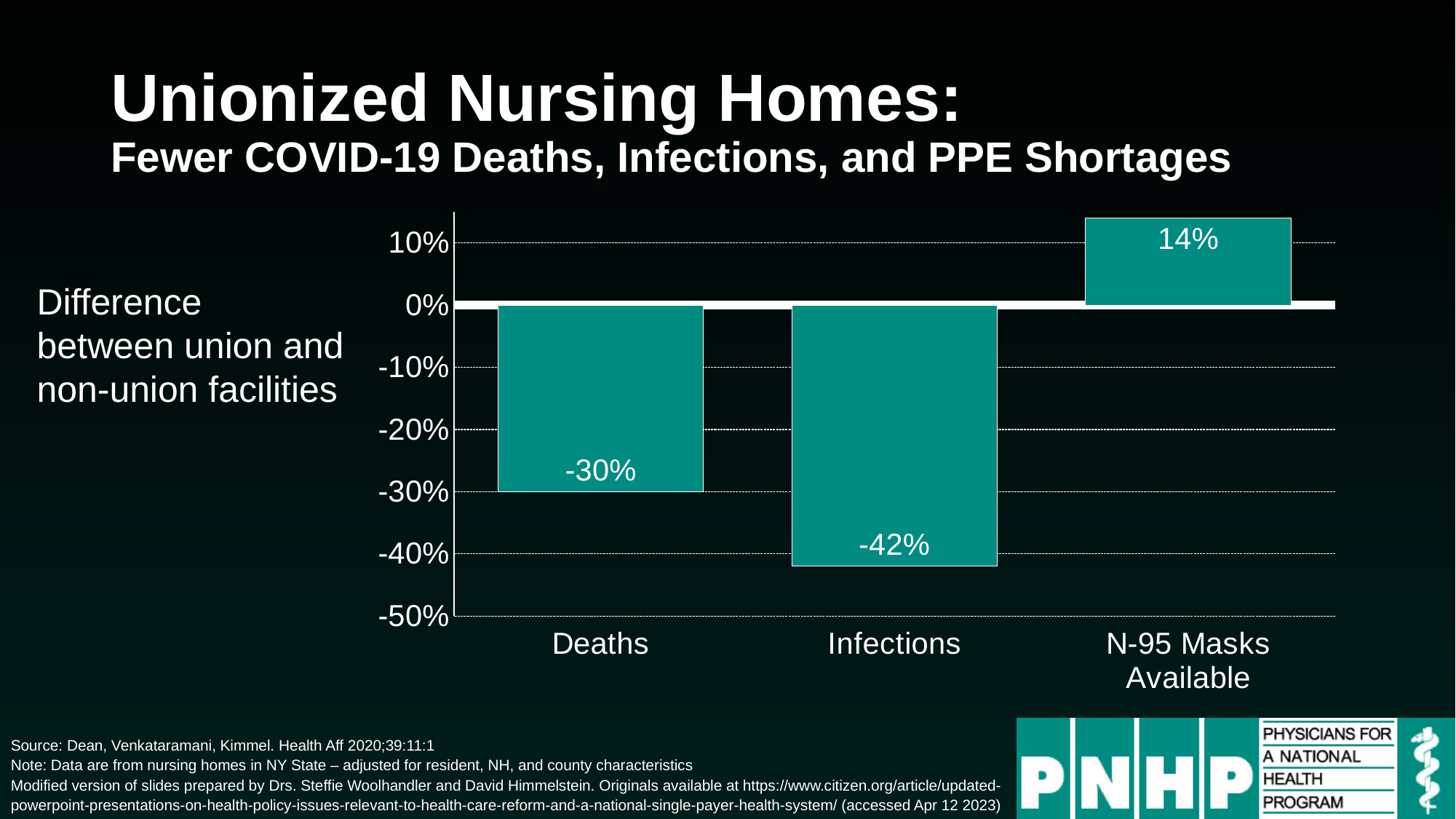
How many categories have negative values? 2 Is the value for Infections greater or less than -40%? less What does the text to the left of the chart say the values represent? Difference between union and non-union facilities Which category has the highest value? N-95 Masks Available What is the value for N-95 Masks Available? 14% Which is larger, the value for Deaths or the value for Infections? Deaths What is the value for Deaths? -30% What kind of chart is shown on the slide? bar chart How many categories are shown on the x axis? 3 Which category has the lowest value? Infections What is the difference between the values for Deaths and Infections? 12 percentage points What is the value for Infections? -42%